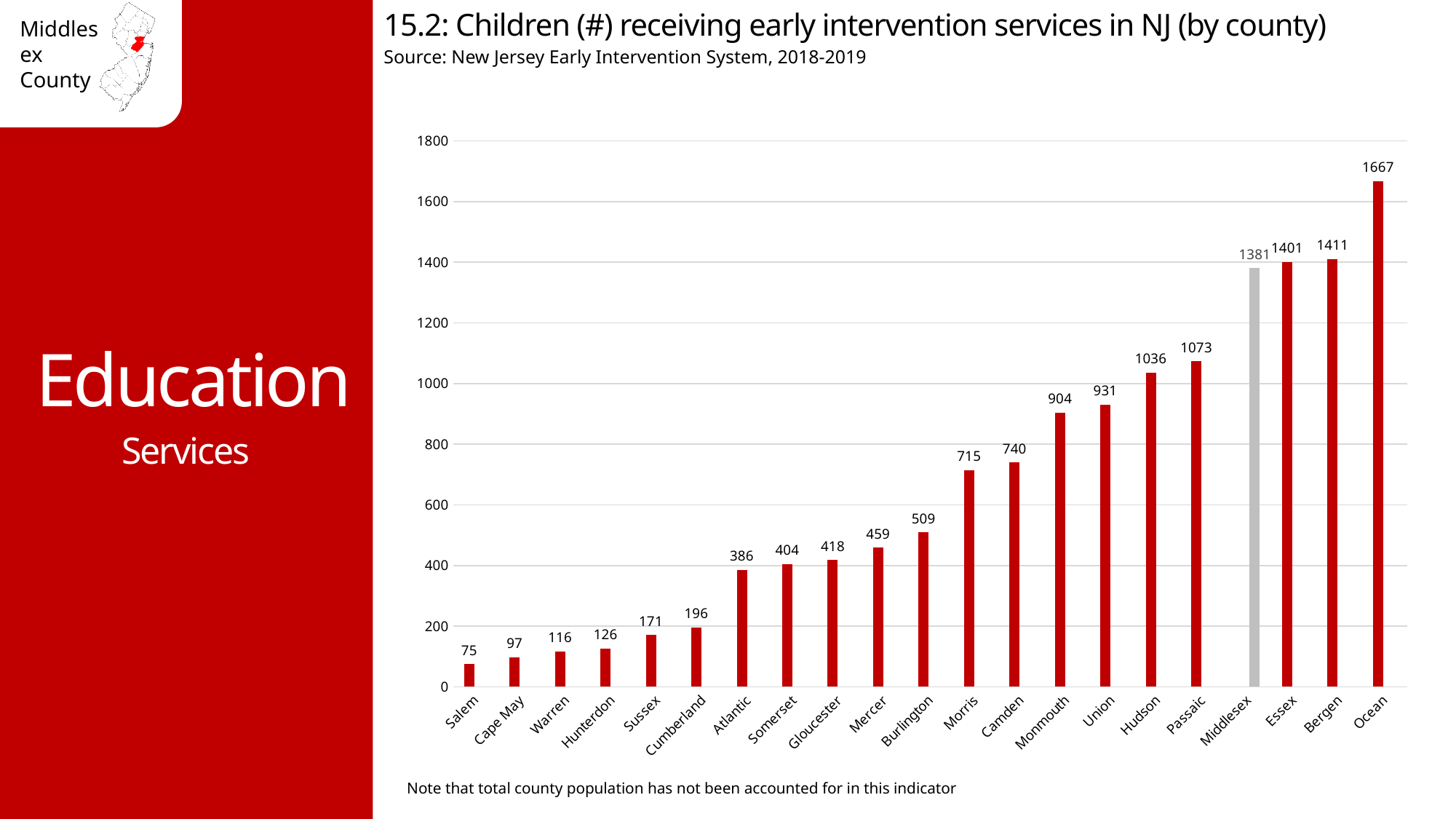
Is the value for Passaic greater or less than 1000? greater How many counties are shown on the chart? 21 Which county has the highest number of children receiving early intervention services? Ocean Which has a larger value, Bergen or Essex? Bergen Which county's bar is coloured grey instead of red? Middlesex What kind of chart is shown on the slide? Bar chart What is the difference between the values for Camden and Morris? 25 How many children received early intervention services in Middlesex County? 1381 Which county has the lowest number of children receiving early intervention services? Salem What is the difference between the values for Ocean and Middlesex? 286 What is the value shown for Atlantic? 386 What is the value shown for Hudson? 1036